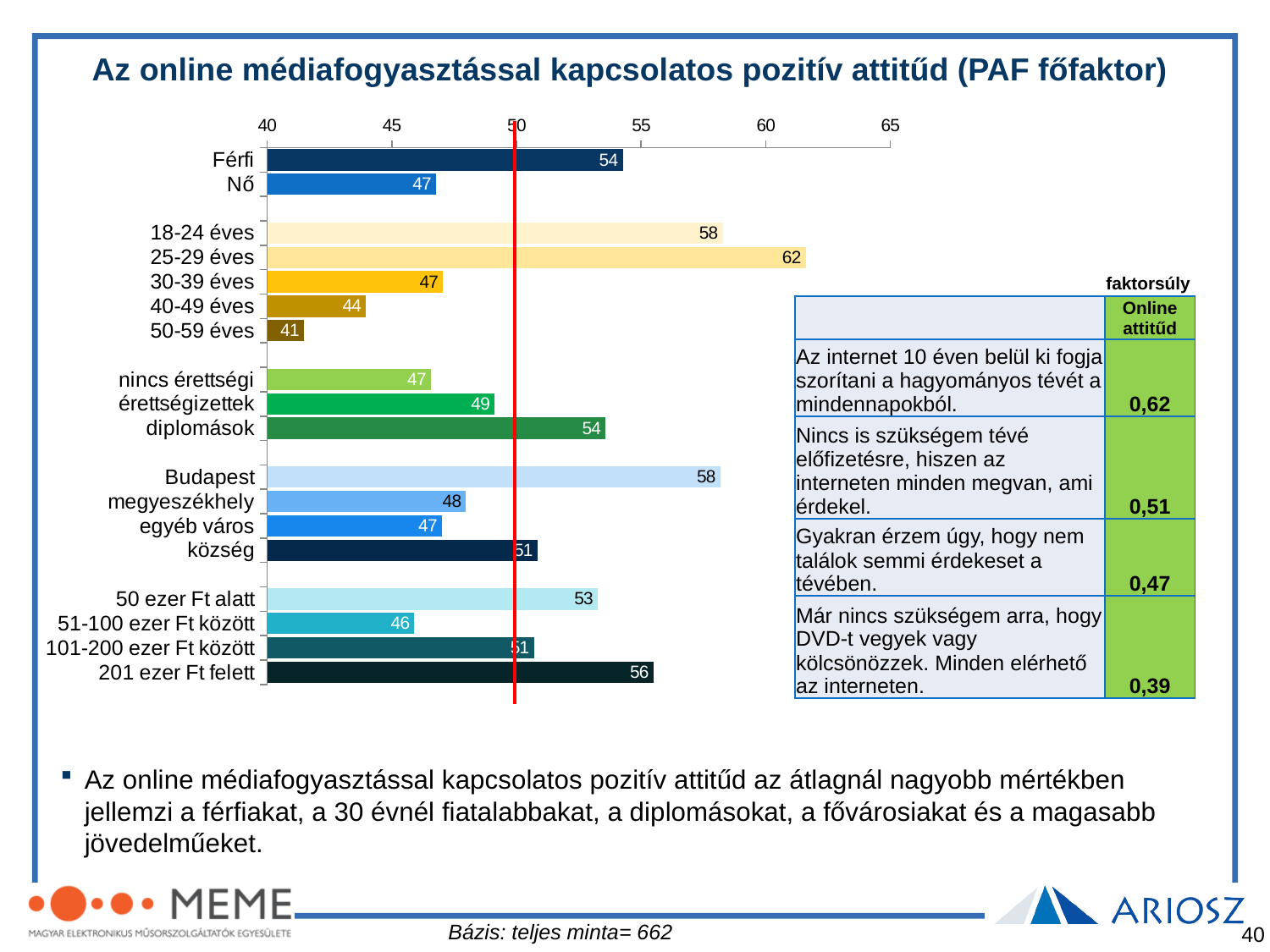
Which category has the highest value in the chart? 25-29 éves What is the difference between the values for Férfi and Nő? 7 What is the value for Budapest? 58 Which has a larger value, diplomások or érettségizettek? diplomások What kind of chart is shown on the slide? bar chart Which category has the lowest value in the chart? 50-59 éves How many bars are plotted in the chart? 18 What is the difference between the values for 201 ezer Ft felett and 51-100 ezer Ft között? 10 What is the value for 50-59 éves? 41 What is the value for 25-29 éves? 62 What is the value for Férfi? 54 Is the value for 40-49 éves greater or less than 45? less